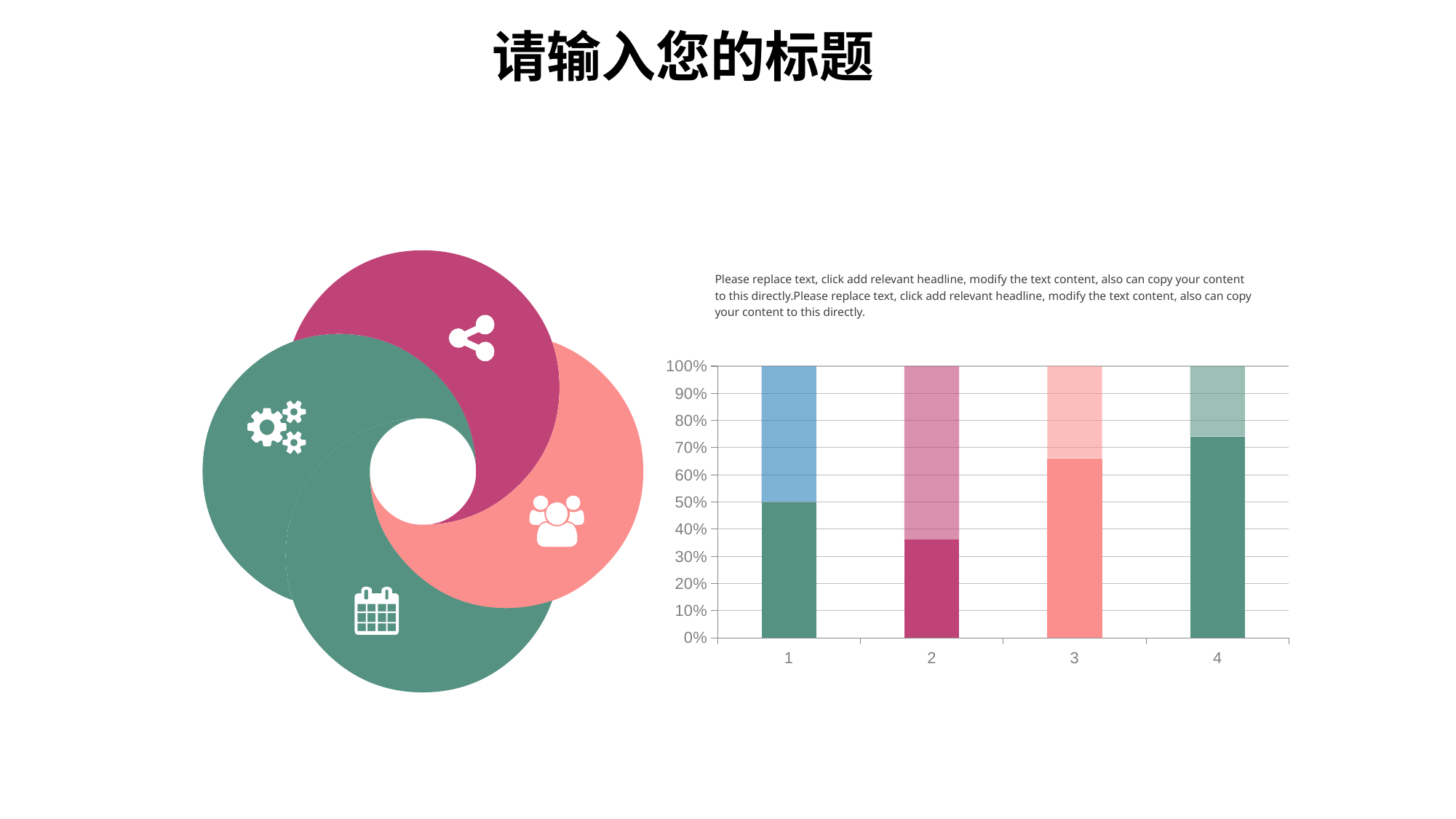
What kind of chart is shown on the right side of the slide? stacked bar chart In the bar chart, which category has the largest bottom segment? 4 In the bar chart, is the bottom segment of bar 2 greater or less than 40%? less What is the highest value shown on the y axis of the bar chart? 100% In the bar chart, what value does the bottom (darker) segment of bar 1 reach? 50% In the bar chart, which category has the smallest bottom segment? 2 In the bar chart, is the bottom segment larger for bar 1 or bar 3? bar 3 In the bar chart, what is the total height of each stacked bar? 100% In the bar chart, is the bottom segment of bar 3 greater or less than 60%? greater What colour is the bottom segment of bar 2 in the bar chart? magenta/pink How many categories are shown on the x axis of the bar chart? 4 In the bar chart, is the bottom segment of bar 4 greater or less than 70%? greater